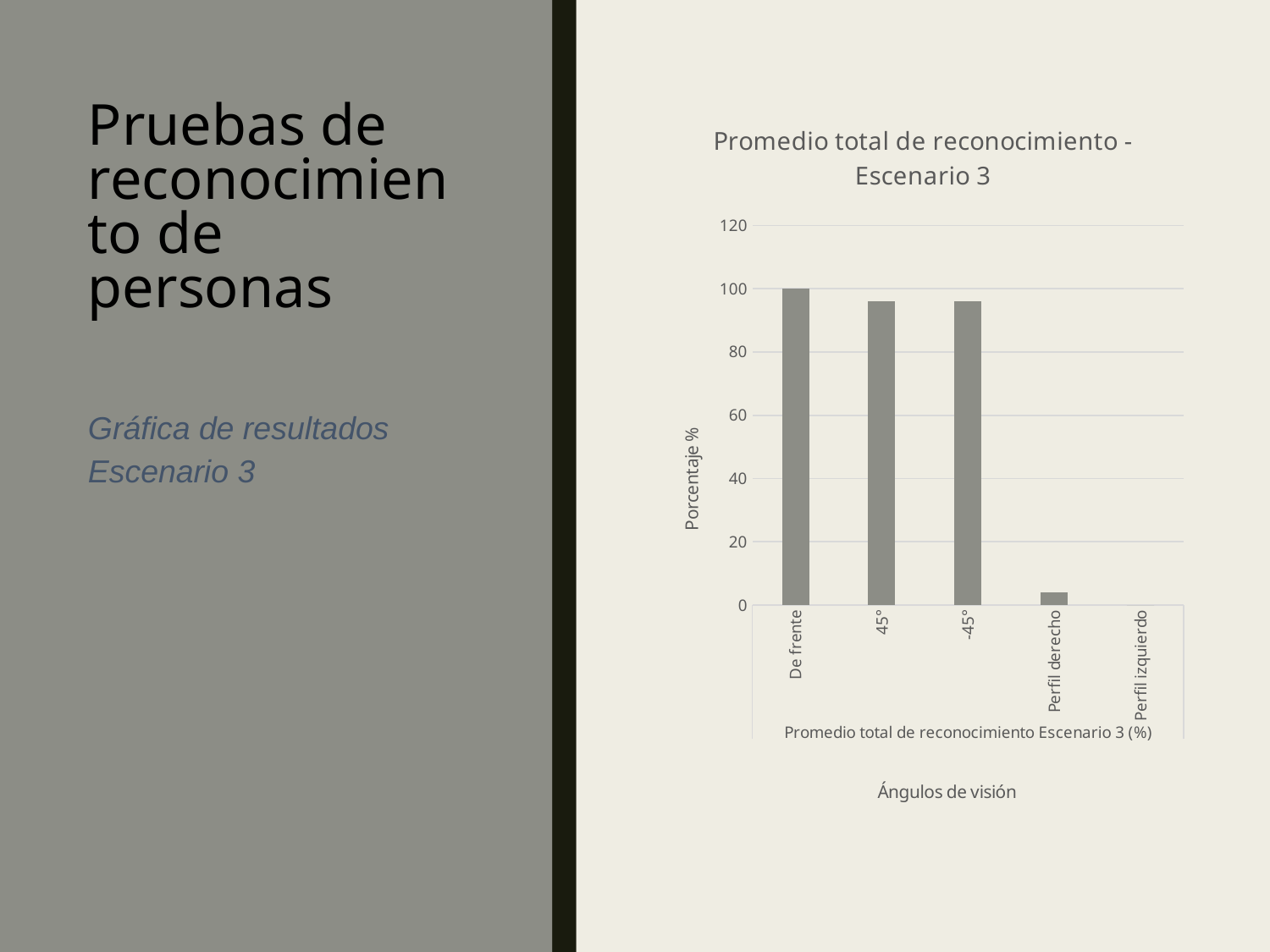
Which category has the lowest value in the chart? Perfil izquierdo Is the value for Perfil derecho greater or less than 20? less What is the label of the vertical axis of the chart? Porcentaje % What is the value for De frente? 100 How many categories are shown on the x axis of the chart? 5 What kind of chart is shown on the slide? Bar chart What is the title of the chart? Promedio total de reconocimiento - Escenario 3 Is the value for -45° greater or less than 100? less Which category has the highest value in the chart? De frente Is the value for 45° greater or less than 80? greater Which is larger, the value for De frente or the value for Perfil derecho? De frente